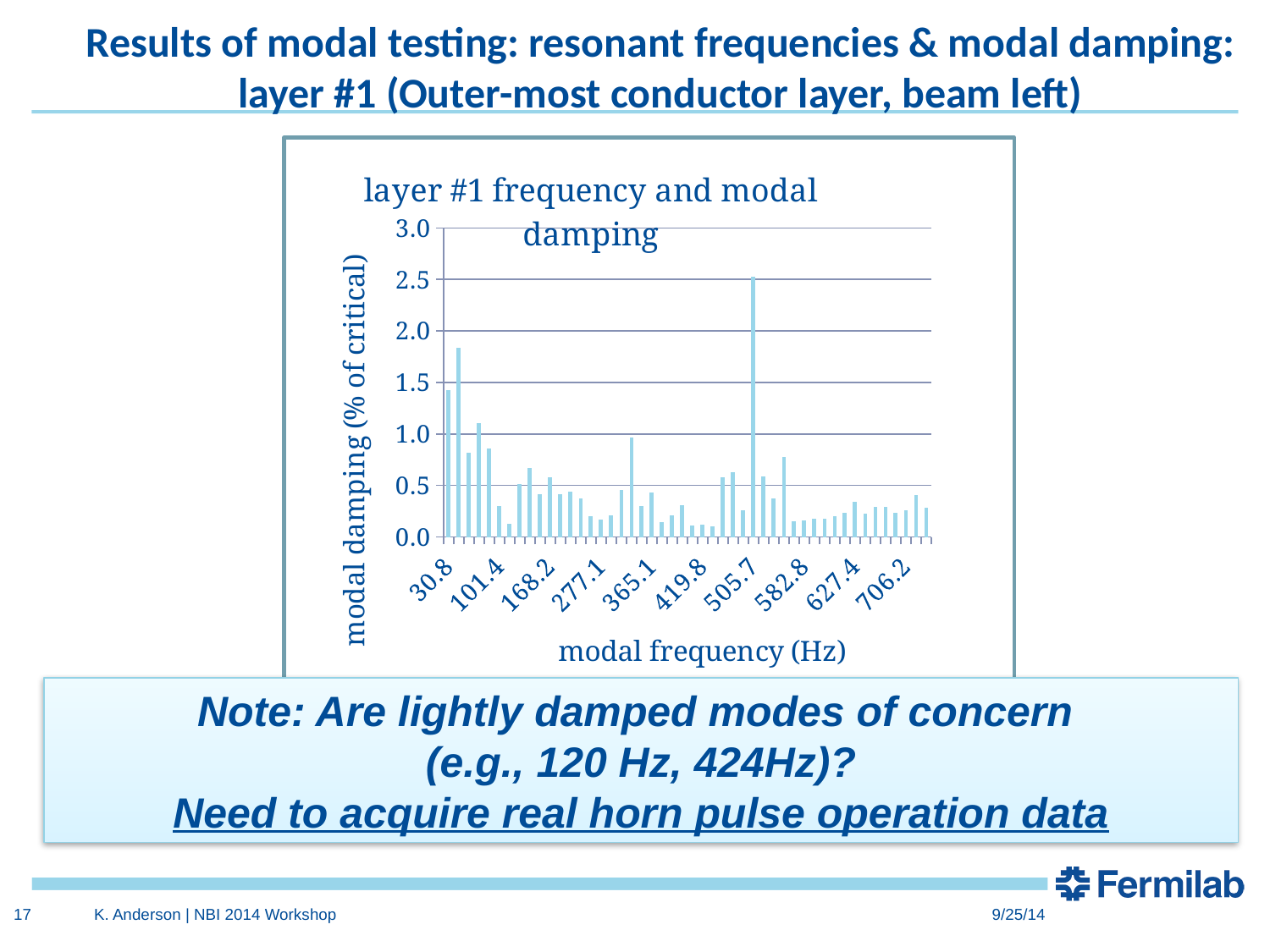
Is the modal damping value at 706.2 Hz greater or less than 0.5? less What is the label of the vertical axis of the chart? modal damping (% of critical) Is the value of the tallest bar in the chart greater or less than 2.0? greater Is the value of the tallest bar in the chart greater or less than 3.0? less What is the highest value shown on the vertical axis of the chart? 3.0 What kind of chart is shown on the slide? bar chart How many frequency labels are printed along the x axis of the chart? 10 What is the title of the chart? layer #1 frequency and modal damping